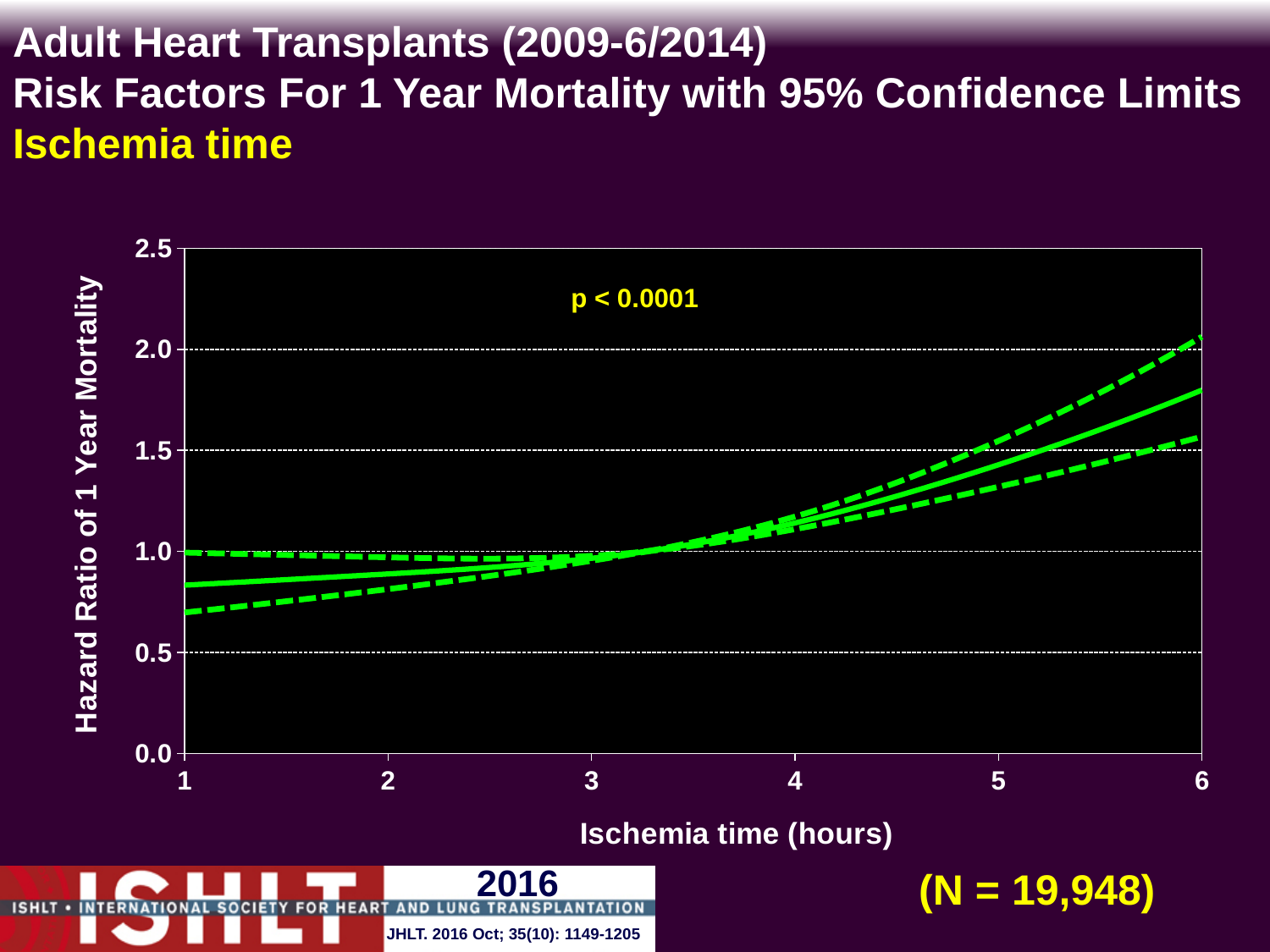
Is the upper 95% confidence limit at an ischemia time of 5 hours greater or less than 2.0? less Is the hazard ratio (solid line) at an ischemia time of 5 hours greater or less than 1.0? greater What is the sample size (N) shown on the slide? 19,948 What is the highest value shown on the y axis? 2.5 Is the hazard ratio (solid line) at an ischemia time of 1 hour greater or less than 1.0? less How many lines are plotted on the chart? 3 What is the label of the x axis? Ischemia time (hours) Does the hazard ratio of 1 year mortality rise or fall as ischemia time increases from 1 to 6 hours? rise What kind of chart is shown on the slide? line chart What p-value is printed on the chart? p < 0.0001